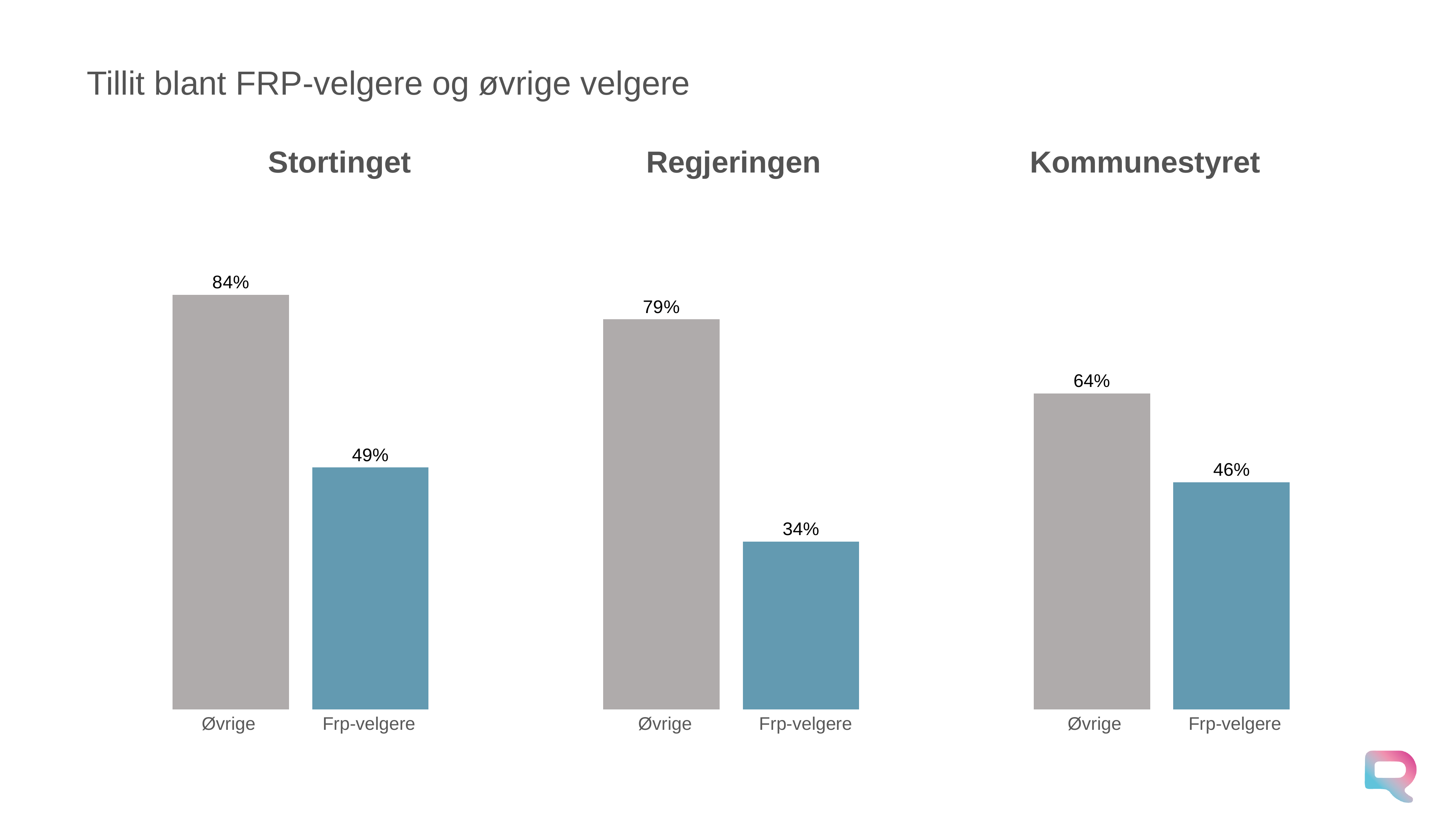
In the Kommunestyret chart, which category has the higher value, Øvrige or Frp-velgere? Øvrige In the Stortinget chart, what is the value for Frp-velgere? 49% In the Regjeringen chart, what is the value for Frp-velgere? 34% What is the title of the slide? Tillit blant FRP-velgere og øvrige velgere In the Stortinget chart, what is the value for Øvrige? 84% In the Regjeringen chart, which category has the lowest value? Frp-velgere In the Kommunestyret chart, what is the value for Øvrige? 64% In the Stortinget chart, what is the difference between Øvrige and Frp-velgere? 35 percentage points What kind of chart is the Regjeringen chart? Bar chart In the Kommunestyret chart, what is the value for Frp-velgere? 46% In the Regjeringen chart, what is the difference between Øvrige and Frp-velgere? 45 percentage points How many categories are shown in the Stortinget chart? 2